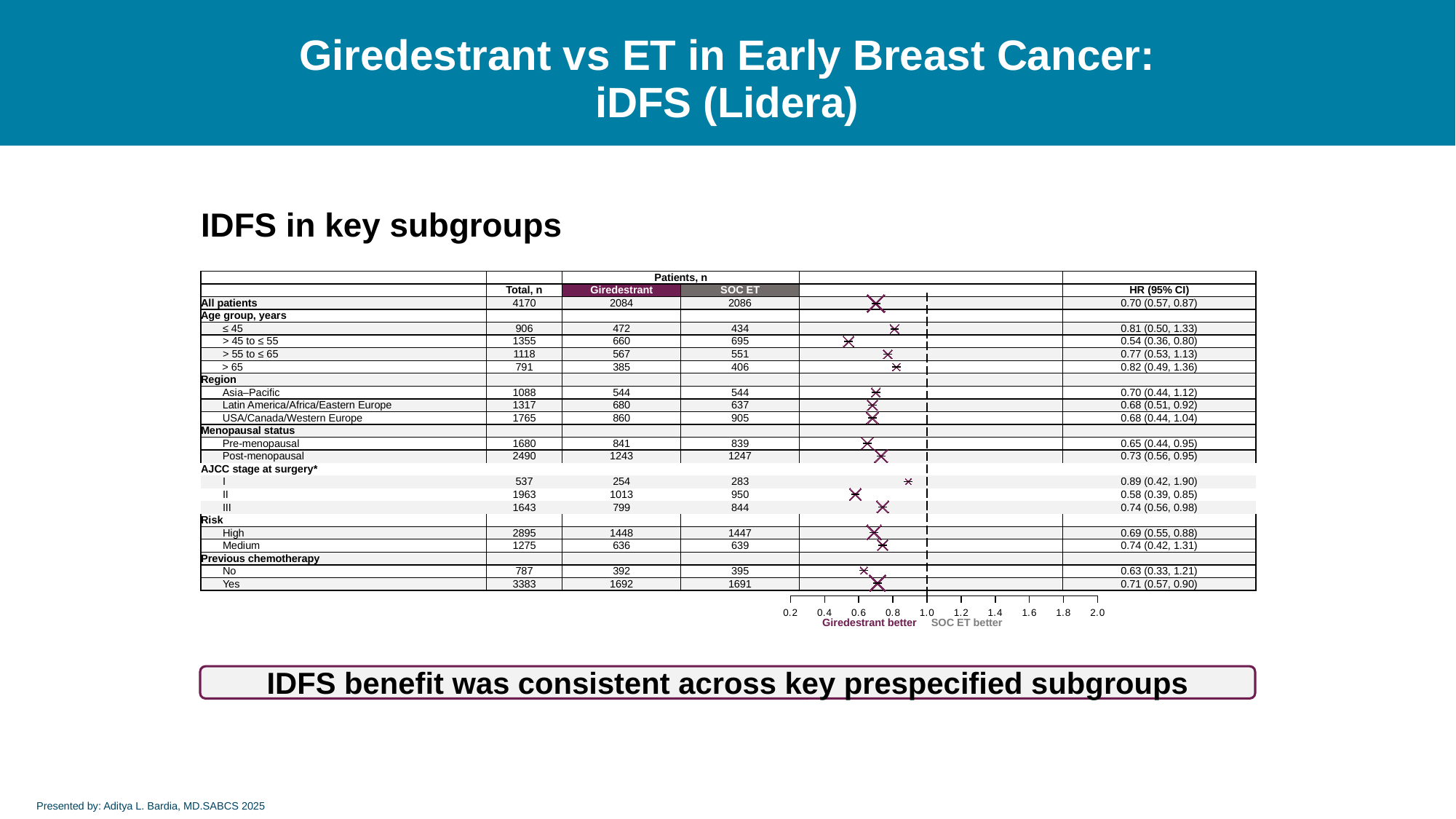
What is the hazard ratio (95% CI) for all patients? 0.70 (0.57, 0.87) Is the hazard ratio point estimate for the high-risk subgroup greater or less than 1.0? less What is the hazard ratio (95% CI) for AJCC stage I at surgery? 0.89 (0.42, 1.90) How many hazard ratio point estimates are plotted in the forest plot, including all patients? 17 What is the difference between the hazard ratio point estimates for AJCC stage I and stage II? 0.31 Which has the larger hazard ratio point estimate: pre-menopausal or post-menopausal patients? Post-menopausal Which subgroup has the highest hazard ratio point estimate? AJCC stage I What is the hazard ratio (95% CI) for patients with no previous chemotherapy? 0.63 (0.33, 1.21) What label appears under the left side of the x axis of the forest plot? Giredestrant better What is the hazard ratio (95% CI) for the > 45 to ≤ 55 age group? 0.54 (0.36, 0.80) Which subgroup has the lowest hazard ratio point estimate? > 45 to ≤ 55 years What kind of chart is shown on the slide? Forest plot